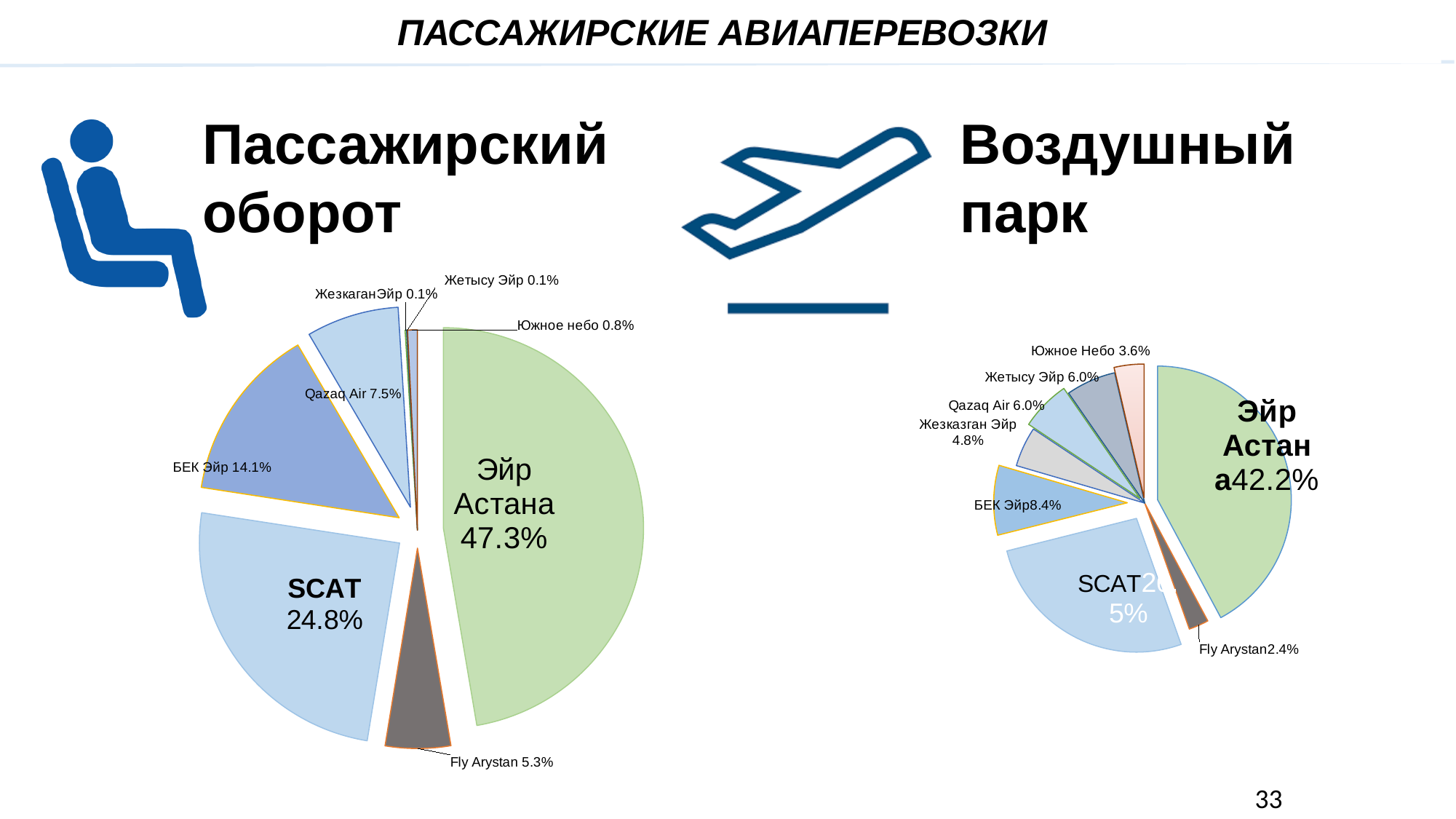
In the "Пассажирский оборот" chart, which airline has the largest share? Эйр Астана In the "Воздушный парк" chart, what is the value for БЕК Эйр? 8.4% In the "Пассажирский оборот" chart, what is the difference between the shares of SCAT and БЕК Эйр? 10.7% In the "Воздушный парк" chart, what is the value for Эйр Астана? 42.2% In the "Пассажирский оборот" chart, which is larger: Qazaq Air or Fly Arystan? Qazaq Air In the "Пассажирский оборот" chart, what share does Эйр Астана have? 47.3% What type of chart is the "Воздушный парк" chart? Pie chart In the "Пассажирский оборот" chart, what is the value for БЕК Эйр? 14.1% How many slices does the "Пассажирский оборот" chart have? 8 In the "Воздушный парк" chart, which airline has the smallest share? Fly Arystan In the "Пассажирский оборот" chart, what is the value for SCAT? 24.8% In the "Воздушный парк" chart, what is the difference between the shares of Жетысу Эйр and Южное Небо? 2.4%